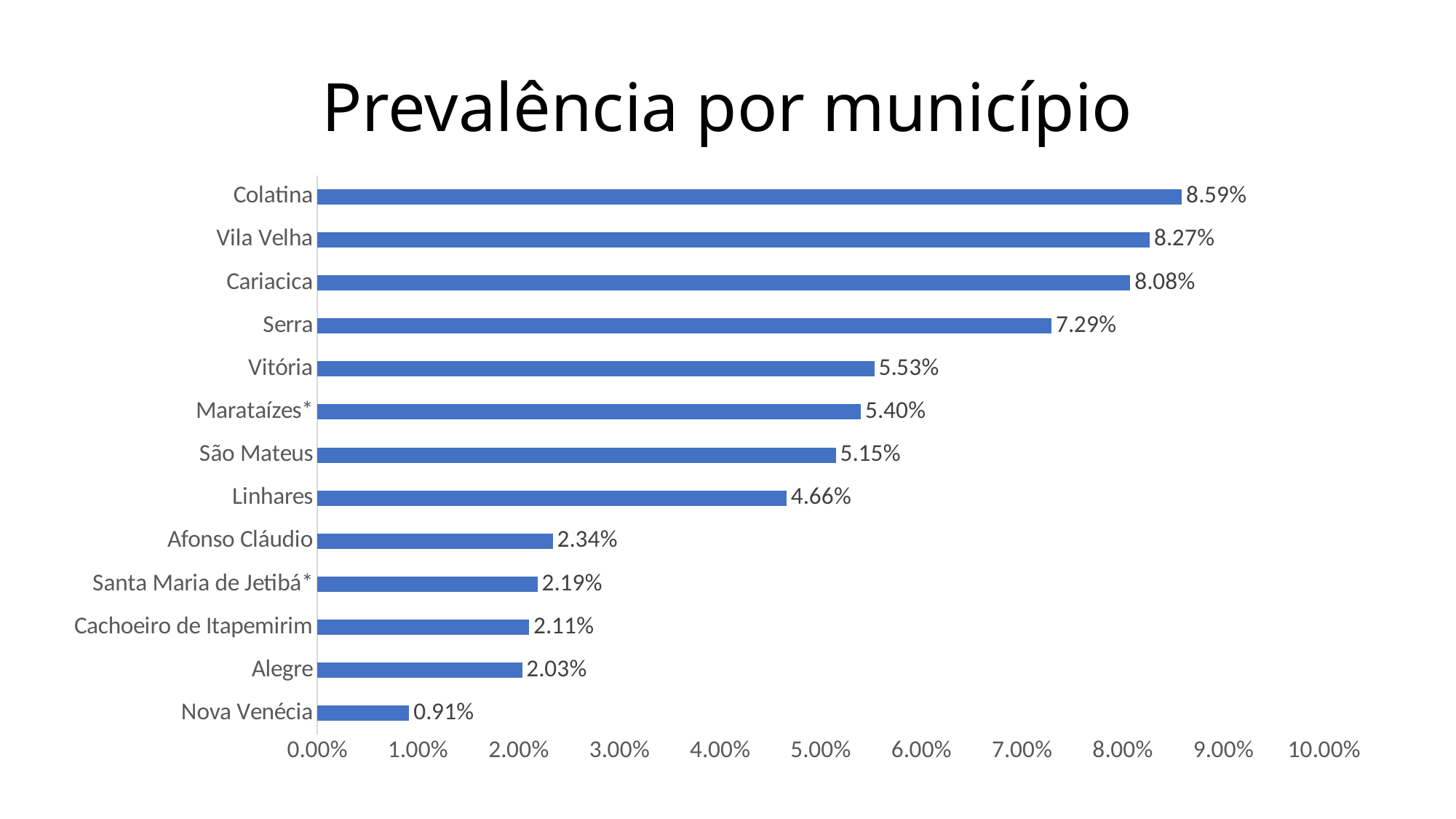
Is the value for São Mateus greater or less than 5.00%? greater Which has a higher prevalence, Cariacica or Serra? Cariacica Which municipality has the highest prevalence? Colatina What is the prevalence value for Linhares? 4.66% What kind of chart is shown on the slide? Bar chart Which municipality has the lowest prevalence? Nova Venécia What is the title of the chart? Prevalência por município How many municipalities are shown in the chart? 13 What is the difference between the prevalence of Colatina and Vila Velha? 0.32% What is the prevalence value for Colatina? 8.59% What is the difference between the prevalence of Serra and Vitória? 1.76% What is the prevalence value for Cachoeiro de Itapemirim? 2.11%